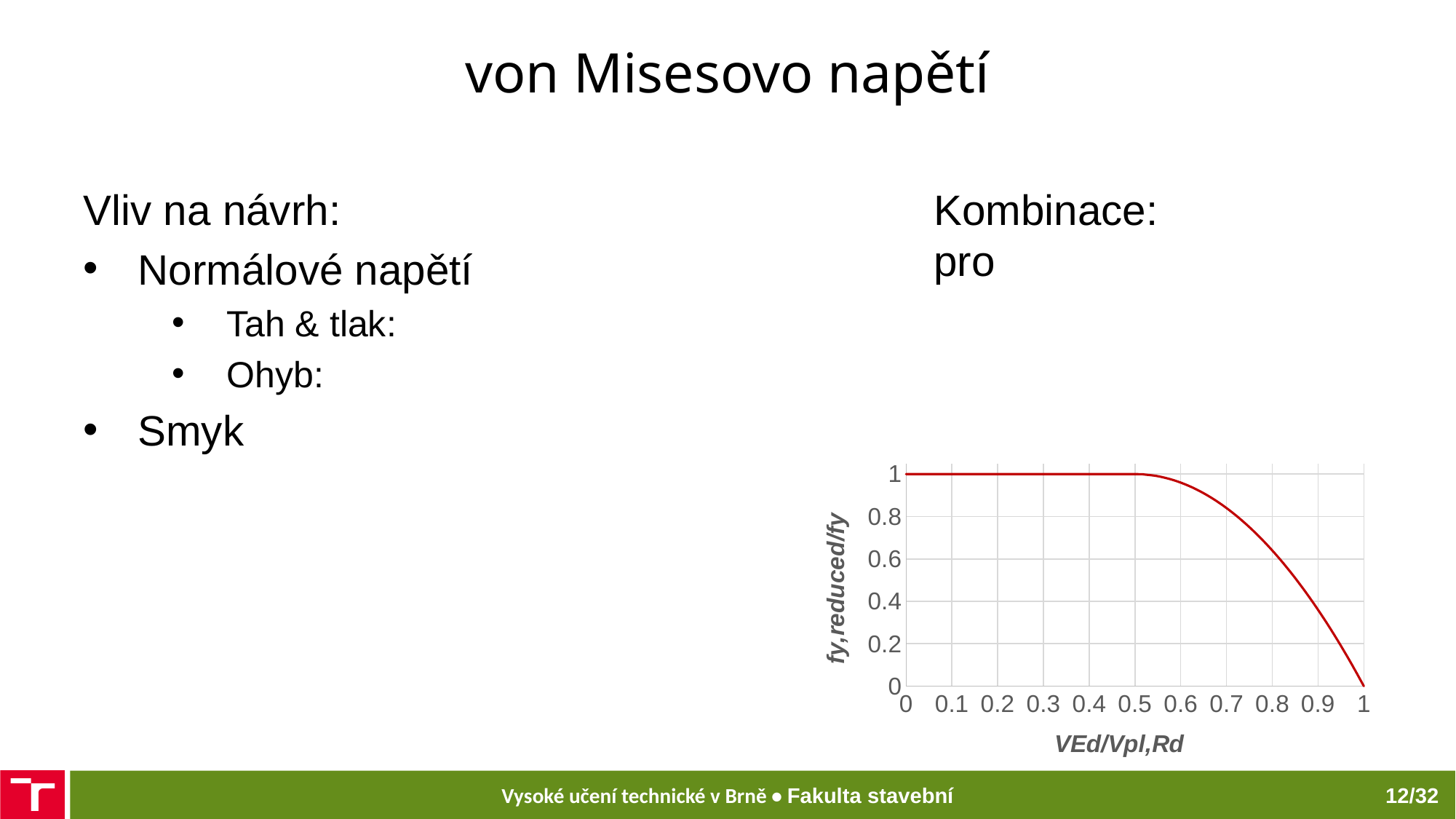
What kind of chart is shown on the slide? line chart What is the value of fy,reduced/fy at VEd/Vpl,Rd = 1? 0 What is the value of fy,reduced/fy at VEd/Vpl,Rd = 0? 1 Does the curve rise or fall as VEd/Vpl,Rd increases from 0.5 to 1? fall What is the label of the x axis of the chart? VEd/Vpl,Rd What is the value of fy,reduced/fy at VEd/Vpl,Rd = 0.5? 1 What is the highest value of fy,reduced/fy reached by the curve? 1 Is the value of fy,reduced/fy at VEd/Vpl,Rd = 0.9 greater or less than 0.6? less What is the label of the y axis of the chart? fy,reduced/fy Which has the larger fy,reduced/fy value: VEd/Vpl,Rd = 0.3 or VEd/Vpl,Rd = 0.9? VEd/Vpl,Rd = 0.3